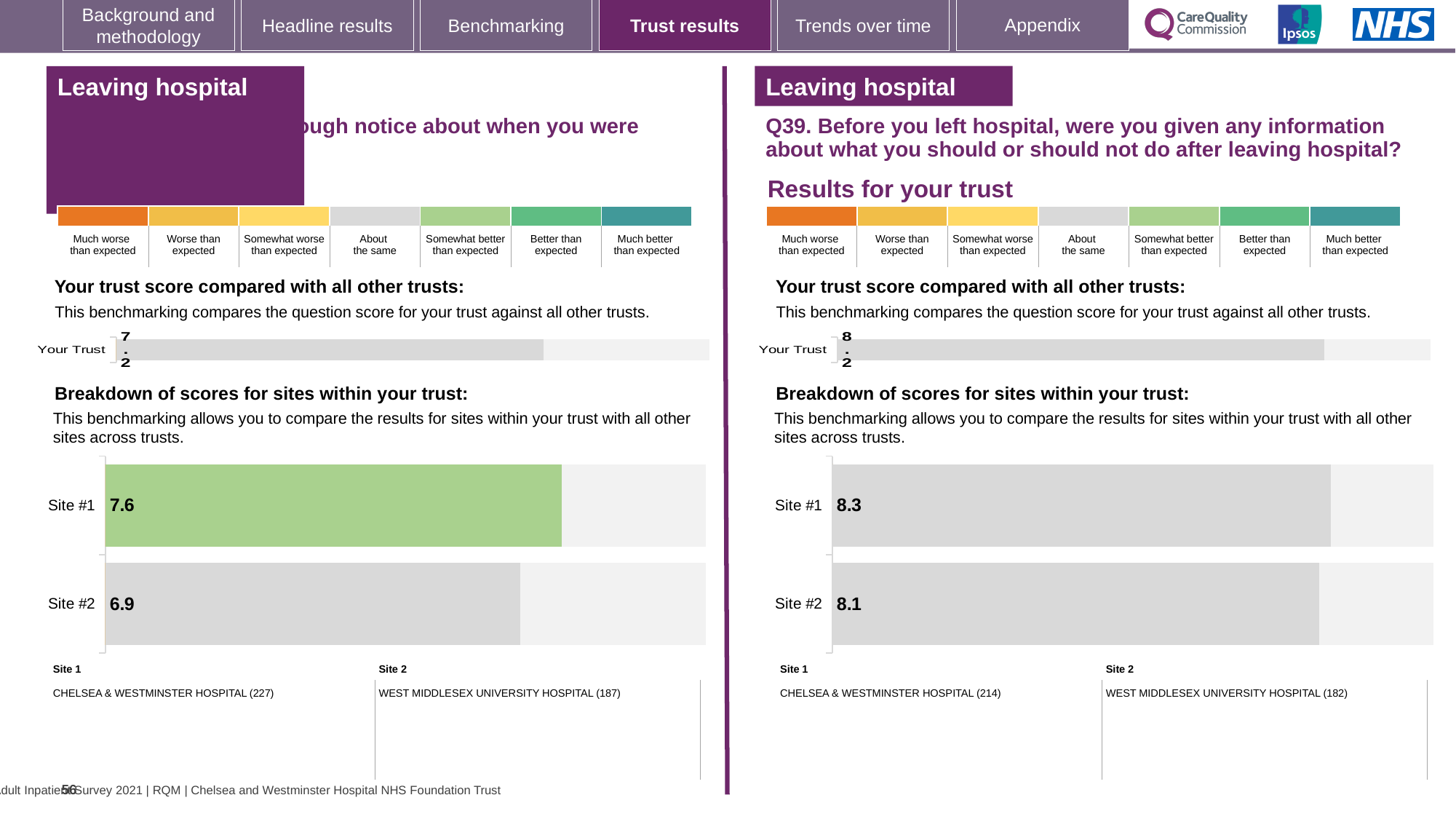
In the site breakdown chart on the left half of the slide, what is the difference between the Site #1 and Site #2 scores? 0.7 In the site breakdown chart on the right half of the slide (Q39), what is the difference between the Site #1 and Site #2 scores? 0.2 In the 'Your trust score compared with all other trusts' chart on the left half of the slide, what is the score shown for Your Trust? 7.2 In the site breakdown chart on the right half of the slide (Q39), what is the score for Site #2? 8.1 How many sites are shown in the site breakdown chart on the right half of the slide (Q39)? 2 What type of chart is used for the breakdown of scores for sites within the trust? Bar chart In the site breakdown chart on the left half of the slide, what is the score for Site #1? 7.6 In the site breakdown chart on the right half of the slide (Q39), what is the score for Site #1? 8.3 In the site breakdown chart on the left half of the slide, what is the score for Site #2? 6.9 In the 'Your trust score compared with all other trusts' chart on the right half of the slide (Q39), what is the score shown for Your Trust? 8.2 Is the Site #1 score in the left-hand site breakdown chart larger or smaller than the Site #1 score in the right-hand (Q39) site breakdown chart? smaller In the site breakdown chart on the left half of the slide, which site has the higher score? Site #1